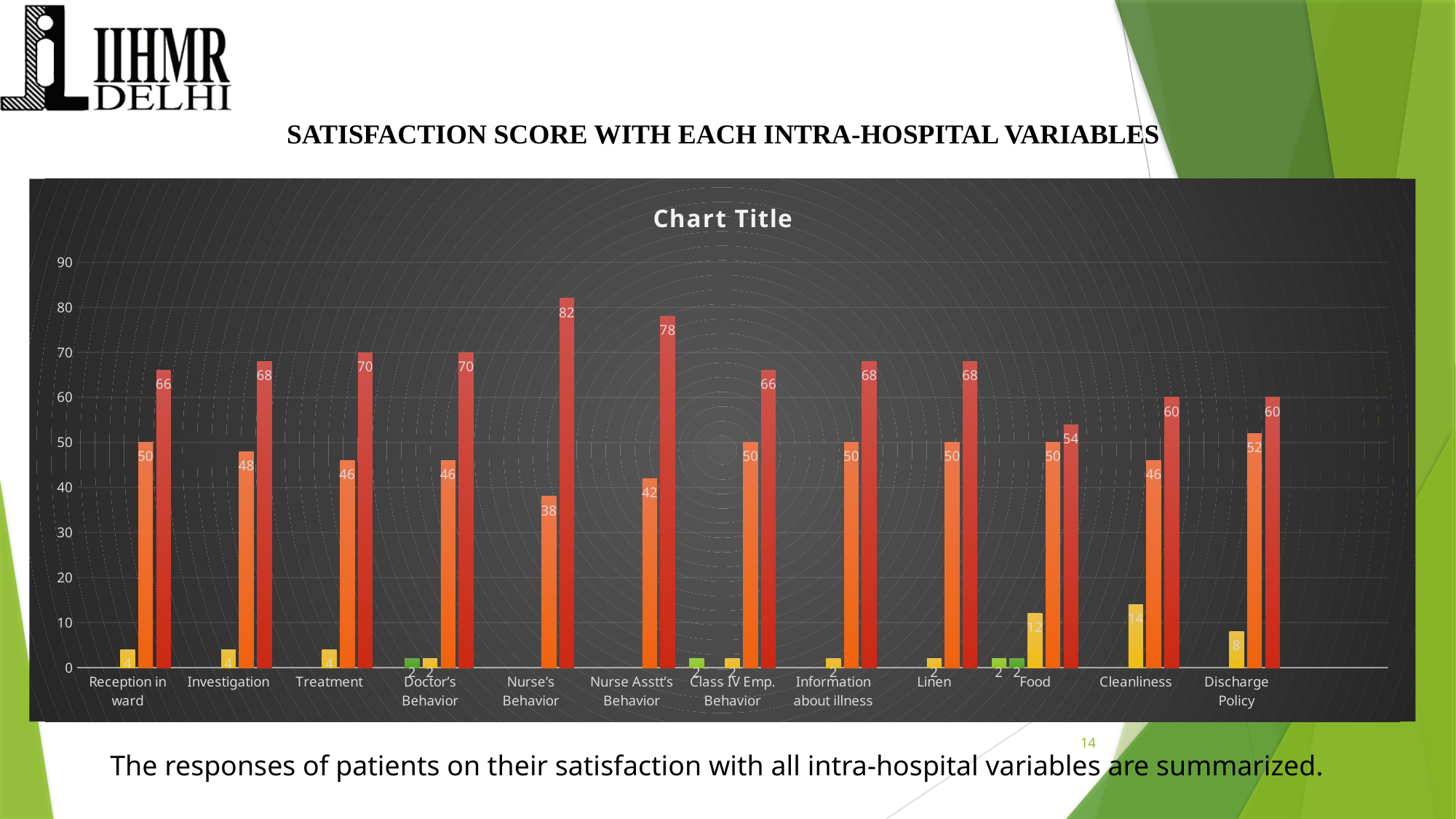
What is the value of the orange bar for Discharge Policy? 52 What type of chart is shown on the slide? bar chart Which category has the highest red bar? Nurse's Behavior Is the value of the orange bar for Nurse's Behavior greater or less than 40? less What is the difference between the red bar and the orange bar for Nurse's Behavior? 44 What is the title printed inside the chart area? Chart Title How many categories are shown along the x axis of the chart? 12 Which category has the lowest red bar? Food What is the value of the yellow bar for Cleanliness? 14 Which is larger, the red bar for Nurse Asstt's Behavior or the red bar for Treatment? Nurse Asstt's Behavior What is the difference between the red bars for Food and Cleanliness? 6 What is the value of the red bar for Nurse's Behavior? 82